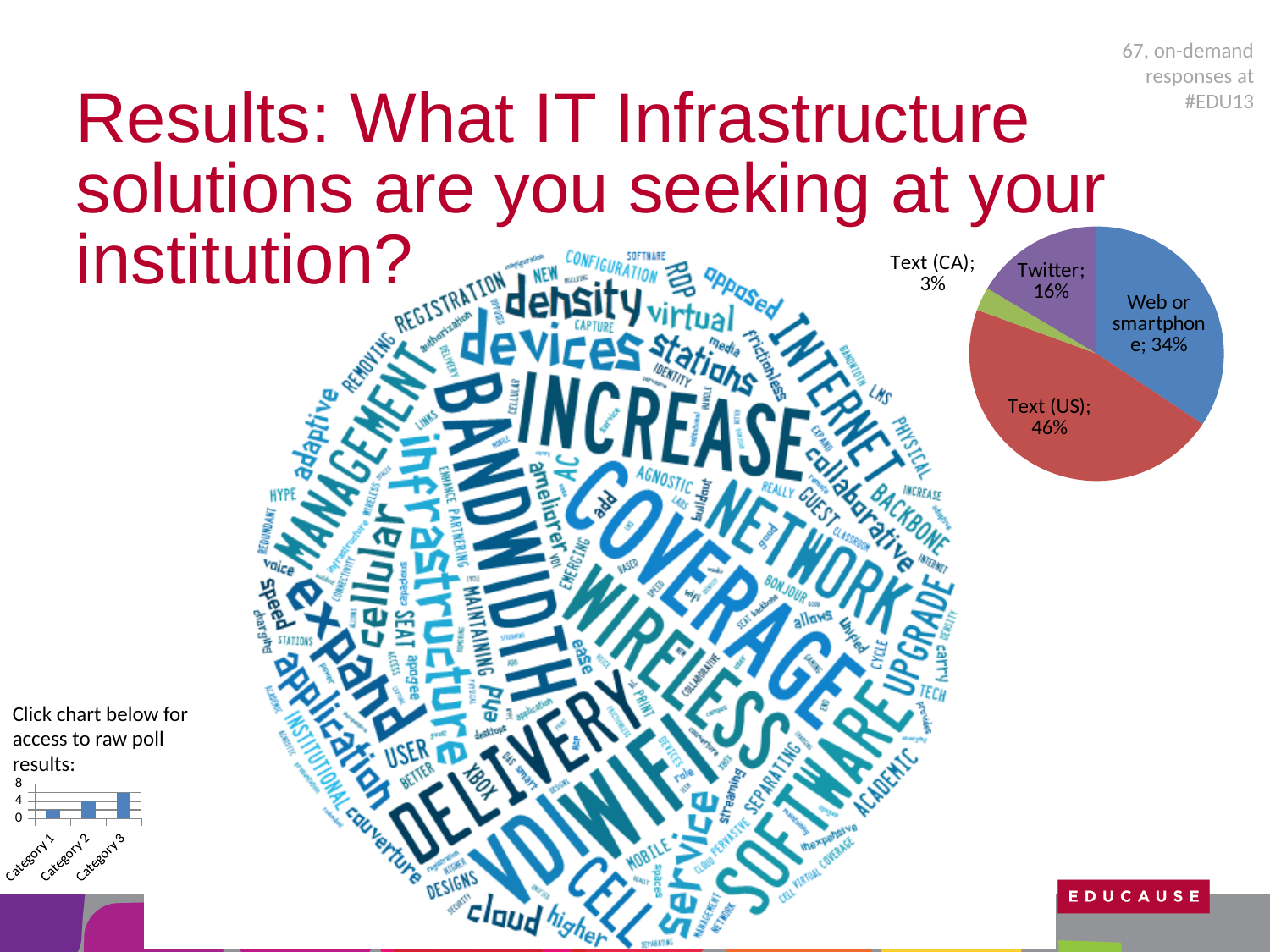
In the pie chart, which response channel has the largest share? Text (US) In the pie chart, which is larger: the share for Twitter or the share for Web or smartphone? Web or smartphone In the pie chart, what is the difference in percentage points between Text (US) and Web or smartphone? 12 What kind of chart is shown in the bottom left of the slide? Bar chart In the pie chart, what share of responses came from Twitter? 16% In the pie chart, what share of responses came from Text (US)? 46% What kind of chart is shown in the top right of the slide? Pie chart In the pie chart, which response channel has the smallest share? Text (CA) How many slices does the pie chart have? 4 In the pie chart, what share of responses came from Text (CA)? 3% In the pie chart, what share of responses came from Web or smartphone? 34% In the bar chart at the bottom left, is the value for Category 1 greater or less than 4? less